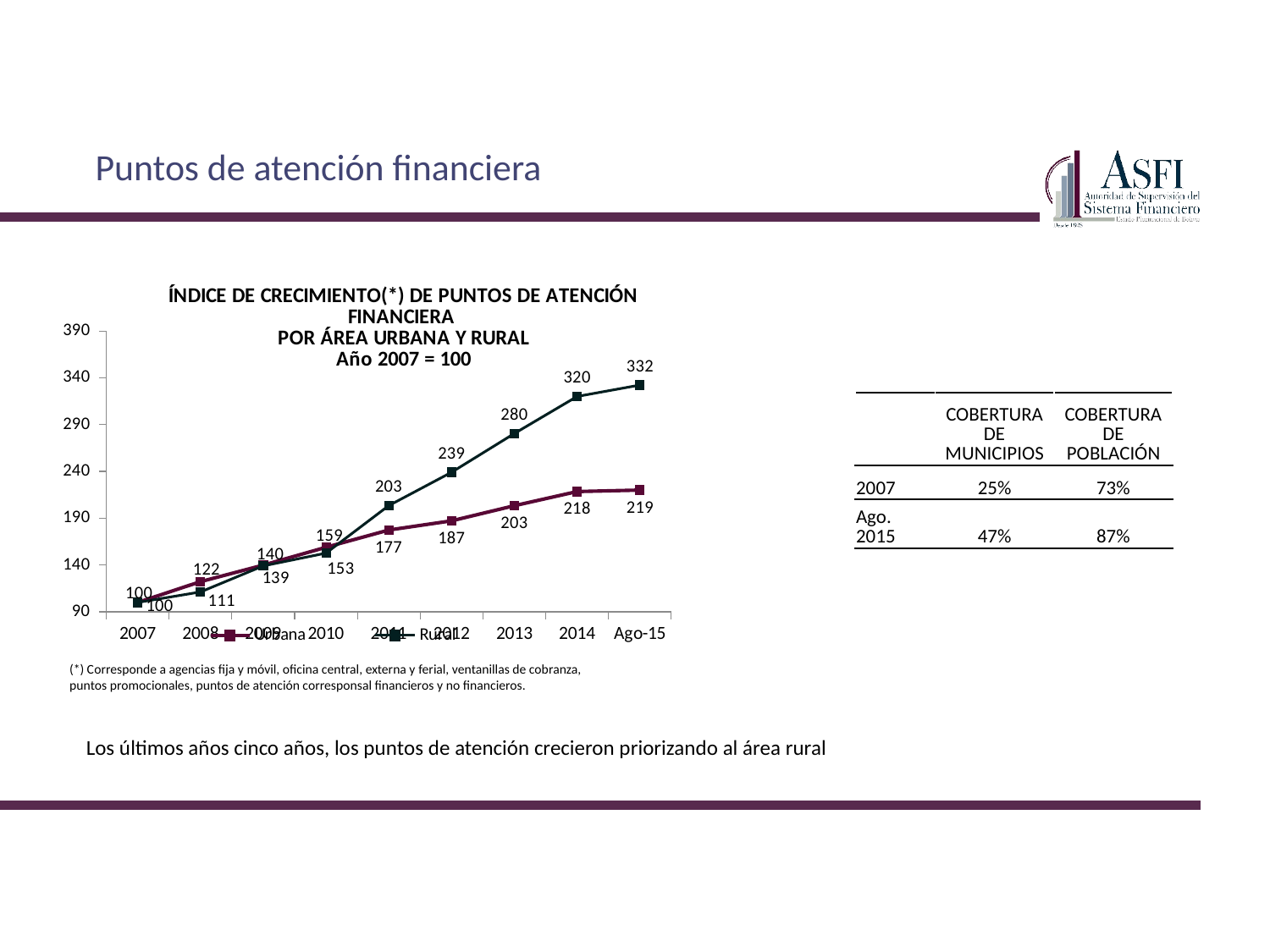
What is the Urbana value for 2014? 218 In which year does the Rural series reach its highest value? Ago-15 What is the Urbana value for 2011? 177 What is the difference between the Rural and Urbana values in Ago-15? 113 Does the Rural series rise or fall from 2007 to Ago-15? rise What is the Rural value for 2012? 239 What type of chart is shown on the slide? line chart How many time points are plotted on the x axis? 9 How many series does the chart legend list? 2 Which series has the larger value in 2013, Urbana or Rural? Rural What is the Rural value for Ago-15? 332 Which series has the larger value in 2008, Urbana or Rural? Urbana